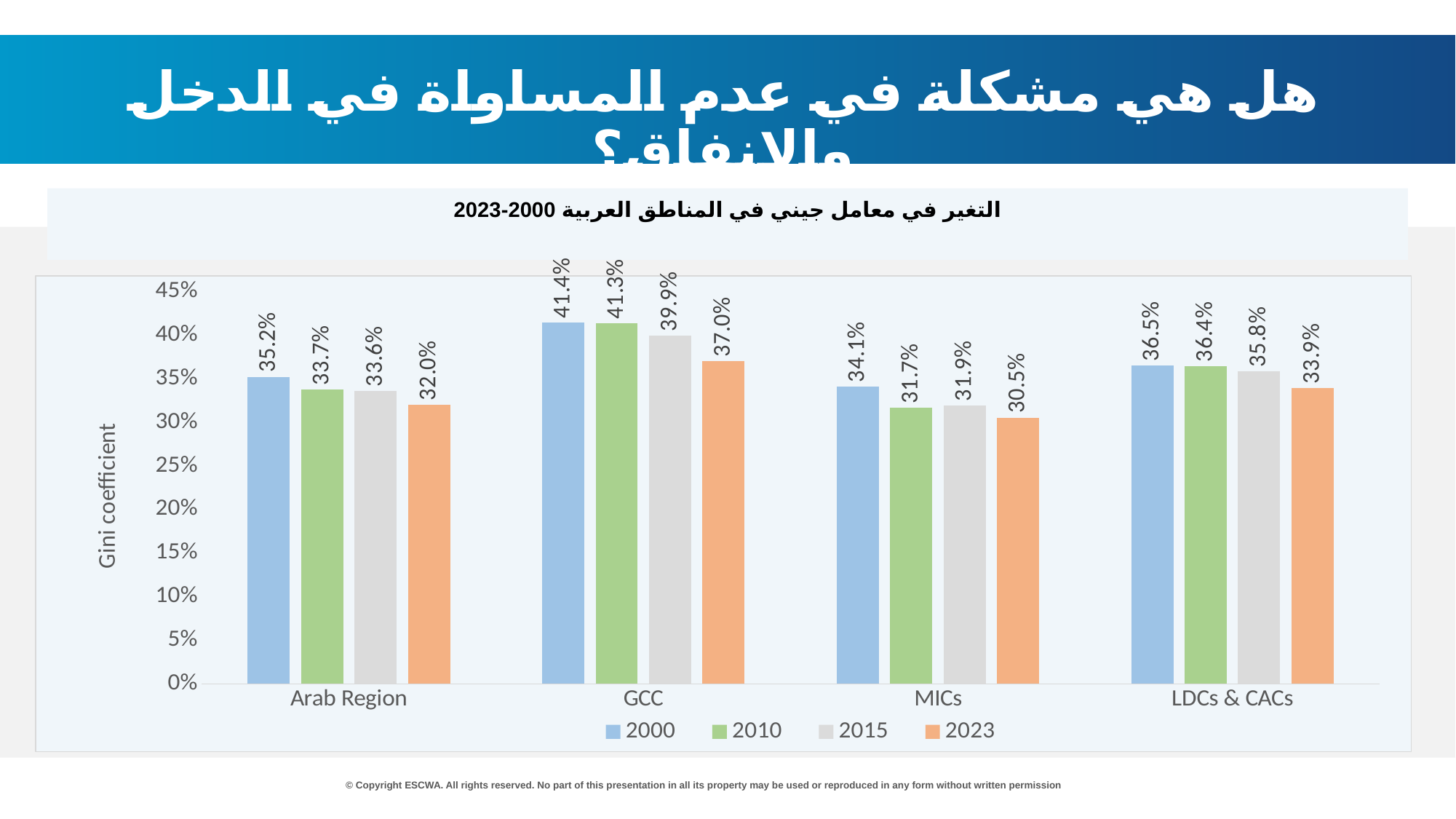
How many categories are shown on the x axis? 4 Which is larger: the 2015 value for GCC or the 2015 value for LDCs & CACs? GCC How many series does the legend list? 4 What is the Gini coefficient for MICs in 2023? 30.5% What is the Gini coefficient for LDCs & CACs in 2015? 35.8% What is the Gini coefficient for GCC in 2000? 41.4% Is the 2023 value for MICs greater or less than 35%? less Which category has the lowest Gini coefficient in 2000? MICs Which category has the highest Gini coefficient in 2023? GCC What is the Gini coefficient for the Arab Region in 2010? 33.7% What kind of chart is shown on the slide? bar chart What is the difference between the Arab Region's Gini coefficient in 2000 and in 2023? 3.2%